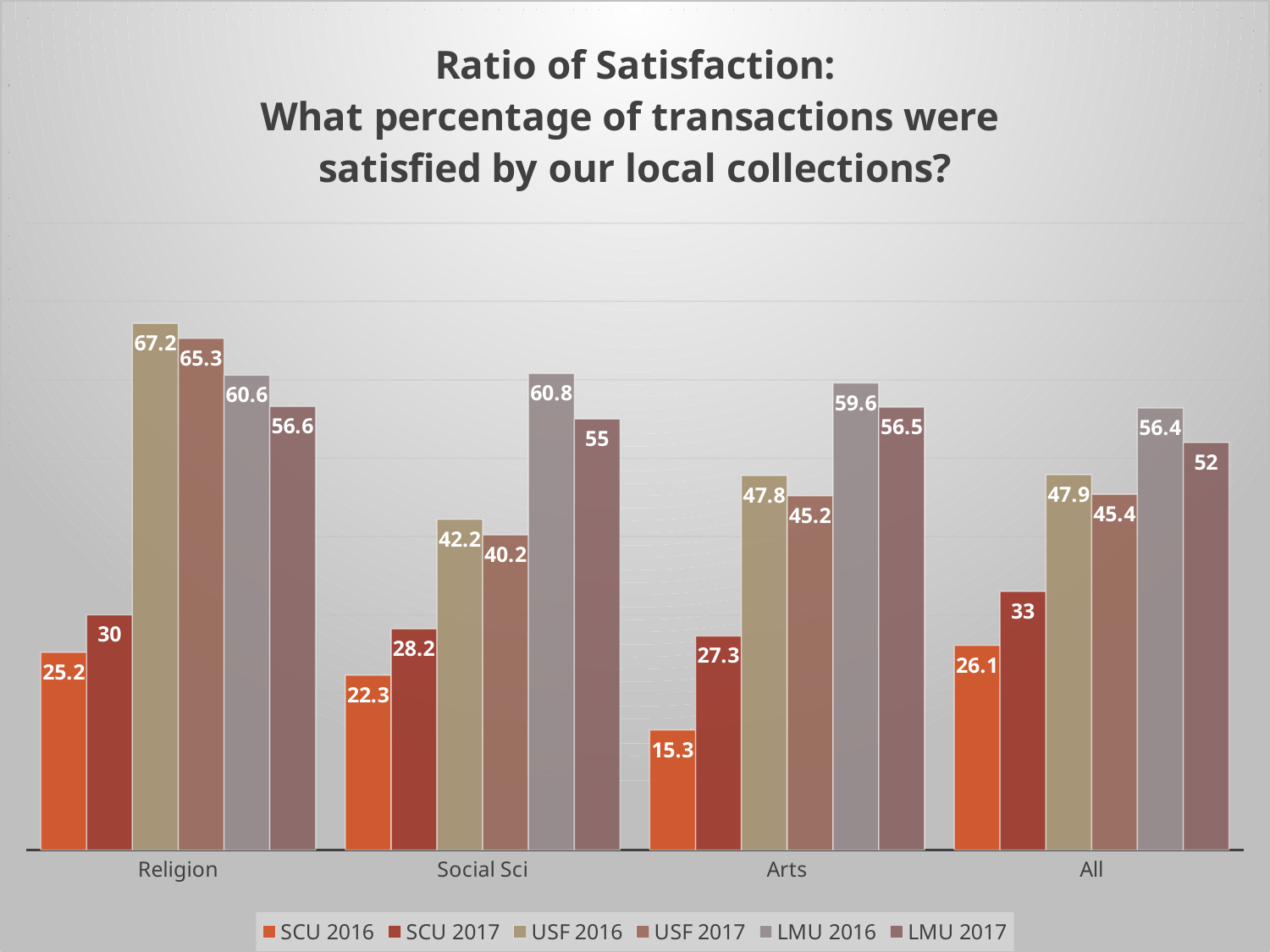
What is the difference between SCU 2017 and SCU 2016 in the All category? 6.9 What is the value for LMU 2016 in the Social Sci category? 60.8 Which series has the highest value in the Religion category? USF 2016 Which series has the lowest value in the Arts category? SCU 2016 What is the value for SCU 2017 in the All category? 33 Does the SCU 2016 value rise or fall from Religion to Social Sci to Arts? Fall What is the difference between LMU 2016 and LMU 2017 in the Arts category? 3.1 How many series does the legend list? 6 What is the value for USF 2016 in the Religion category? 67.2 Which is larger in the Social Sci category: USF 2016 or USF 2017? USF 2016 How many categories are shown on the x axis? 4 What kind of chart is shown on the slide? Bar chart